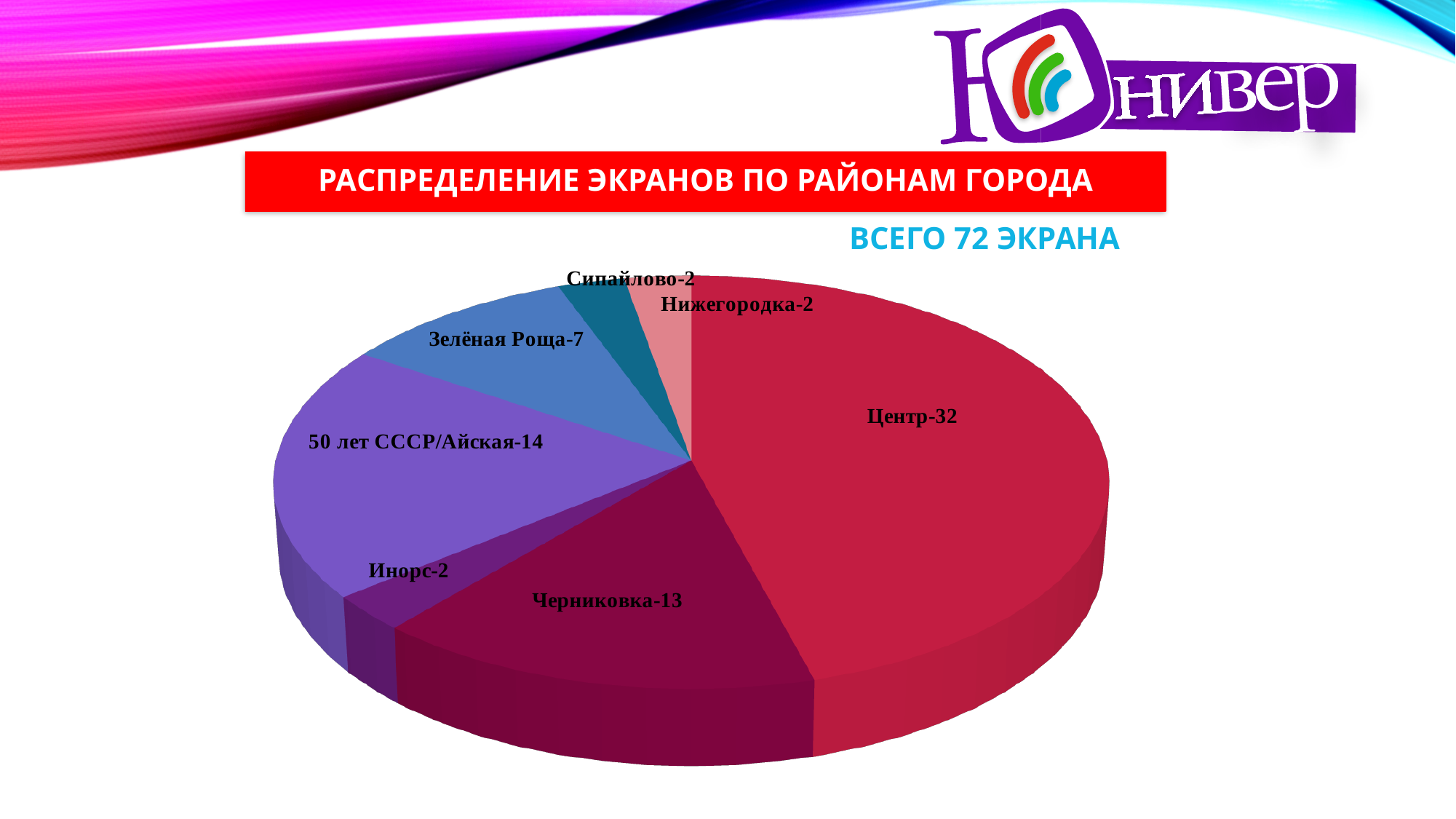
What kind of chart is shown on the slide? Pie chart What is the value shown for Черниковка? 13 How many screens does the Центр slice represent? 32 What is the difference between the values for Центр and Черниковка? 19 What is the value shown for 50 лет СССР/Айская? 14 How many districts (slices) are shown on the pie chart? 7 Which district has the largest number of screens? Центр Which is larger, the value for 50 лет СССР/Айская or the value for Черниковка? 50 лет СССР/Айская What is the total number of screens across all districts, as stated on the slide? 72 What is the title of the chart on the slide? РАСПРЕДЕЛЕНИЕ ЭКРАНОВ ПО РАЙОНАМ ГОРОДА What is the value shown for Зелёная Роща? 7 What is the smallest value shown on the pie chart? 2